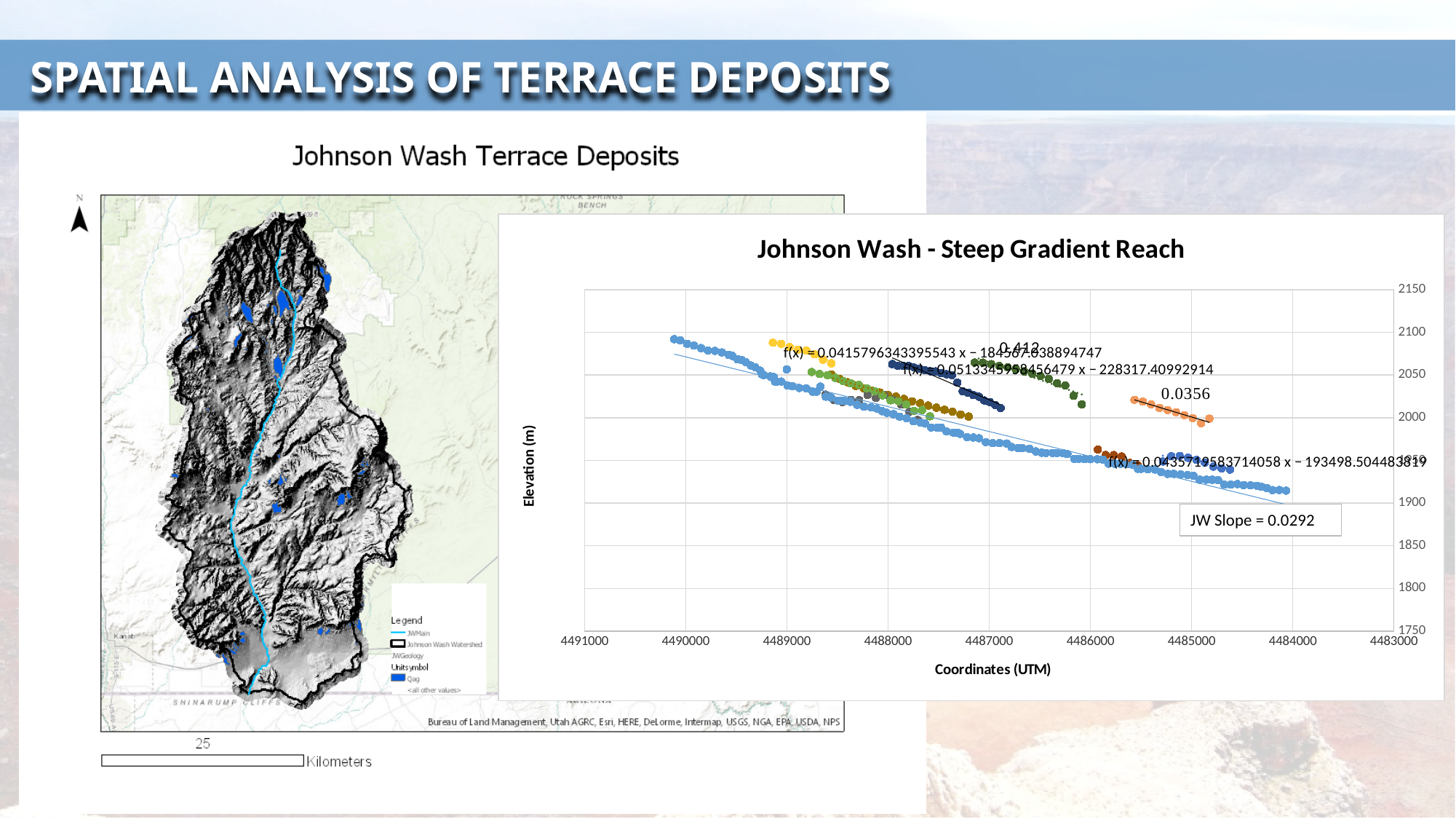
In the 'Johnson Wash - Steep Gradient Reach' chart, is the elevation of the light-blue series near coordinate 4484000 greater or less than 1950? less In the 'Johnson Wash - Steep Gradient Reach' chart, is the elevation of the light-blue series near coordinate 4490000 greater or less than 2050? greater What kind of chart is 'Johnson Wash - Steep Gradient Reach'? scatter chart In the 'Johnson Wash - Steep Gradient Reach' chart, is the elevation of the orange series of points greater or less than 1950? greater In the 'Johnson Wash - Steep Gradient Reach' chart, what is the lowest value shown on the elevation axis? 1750 In the 'Johnson Wash - Steep Gradient Reach' chart, does the elevation of the main light-blue series rise or fall from left to right across the plot? fall In the 'Johnson Wash - Steep Gradient Reach' chart, what value is given for the JW Slope in the text box? 0.0292 In the 'Johnson Wash - Steep Gradient Reach' chart, what slope value is printed above the orange series of points? 0.0356 In the 'Johnson Wash - Steep Gradient Reach' chart, what is the slope coefficient in the trendline equation f(x) = 0.0415796343395543 x − ...? 0.0415796343395543 In the 'Johnson Wash - Steep Gradient Reach' chart, what is the label of the vertical axis? Elevation (m) In the 'Johnson Wash - Steep Gradient Reach' chart, what is the highest value shown on the elevation axis? 2150 What is the title of the chart on the right side of the slide? Johnson Wash - Steep Gradient Reach